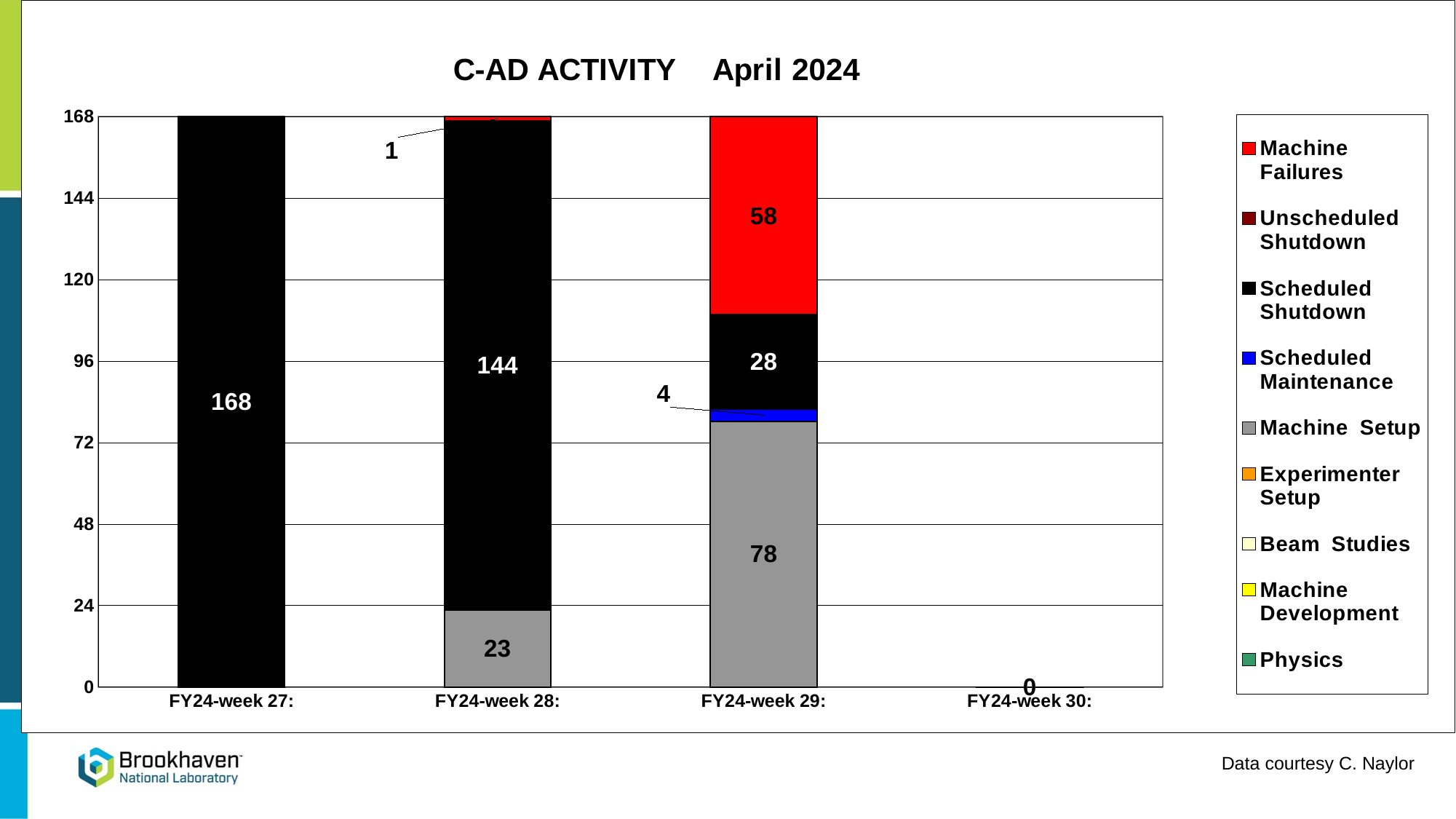
What is the value of Scheduled Maintenance for FY24-week 29? 4 What is the total of the stacked bar for FY24-week 29? 168 Which week has the lowest total value? FY24-week 30 Which week has the larger Scheduled Shutdown value, FY24-week 28 or FY24-week 29? FY24-week 28 What is the value of Scheduled Shutdown for FY24-week 29? 28 What is the value of Machine Failures for FY24-week 29? 58 What kind of chart is shown on the slide? Stacked bar chart What is the value of Scheduled Shutdown for FY24-week 27? 168 What is the difference between Machine Setup in FY24-week 29 and FY24-week 28? 55 How many series does the legend list? 9 What is the value of Machine Setup for FY24-week 28? 23 How many weeks are shown on the x axis? 4